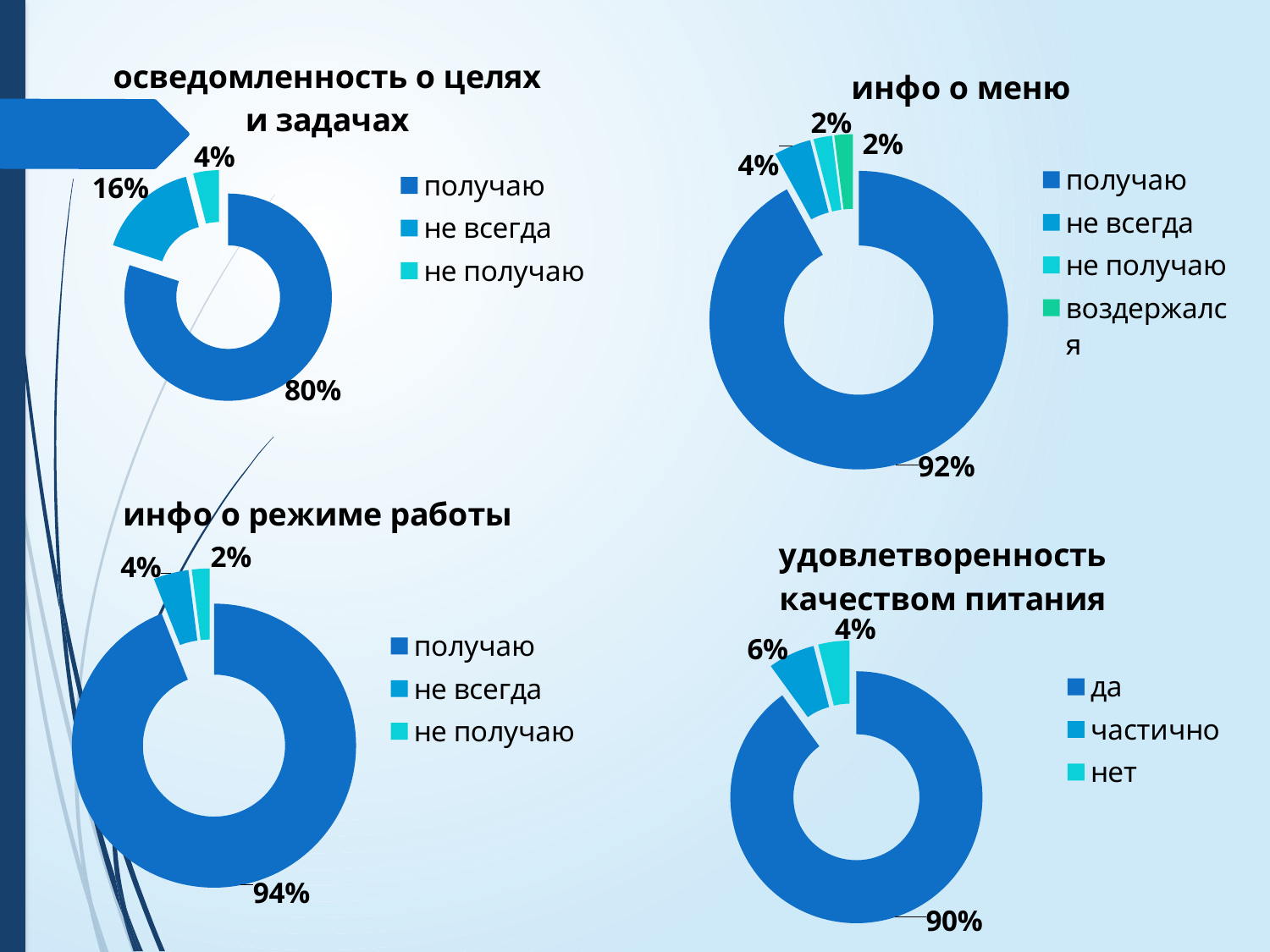
Which is larger: the "получаю" share in "инфо о меню" or the "получаю" share in "инфо о режиме работы"? инфо о режиме работы In the chart titled "инфо о меню", what share is labelled for "получаю"? 92% In the chart titled "удовлетворенность качеством питания", what share is labelled for "частично"? 6% In the chart titled "инфо о режиме работы", what share is labelled for "не всегда"? 4% In the chart titled "осведомленность о целях и задачах", what share is labelled for "не всегда"? 16% In the chart titled "удовлетворенность качеством питания", which category has the smallest share? нет How many charts are shown on the slide? 4 In the chart titled "инфо о режиме работы", which category has the largest share? получаю In the chart titled "осведомленность о целях и задачах", what is the difference between the shares for "получаю" and "не всегда"? 64% What kind of chart is used for "удовлетворенность качеством питания"? doughnut chart In the chart titled "инфо о меню", how many entries does the legend list? 4 In the chart titled "осведомленность о целях и задачах", what share is labelled for "получаю"? 80%